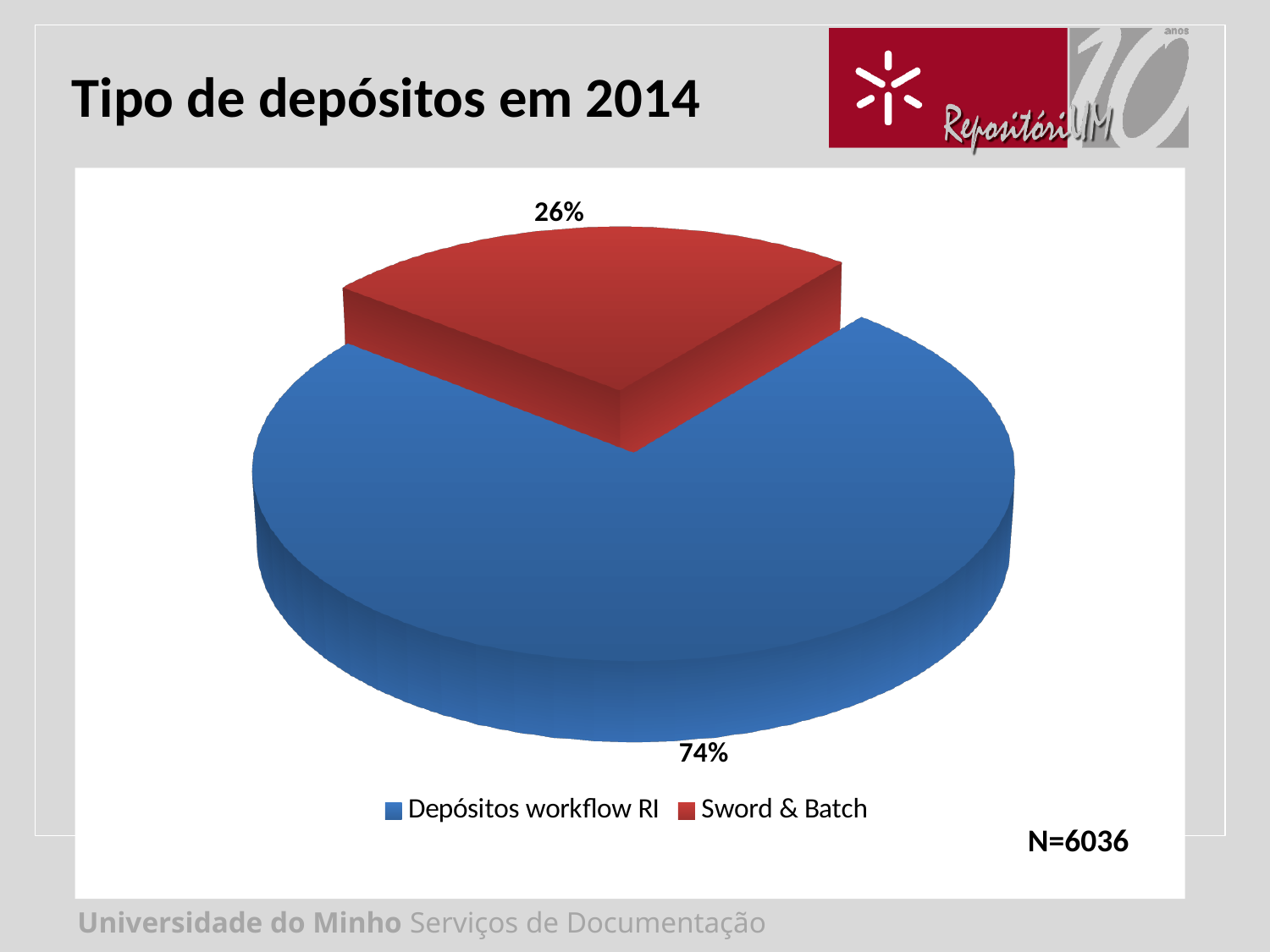
What is the difference in percentage points between Depósitos workflow RI and Sword & Batch? 48 What is the value of N shown next to the chart? 6036 Which category has the largest slice of the pie? Depósitos workflow RI How many entries does the legend list? 2 Which is larger, the share for Sword & Batch or the share for Depósitos workflow RI? Depósitos workflow RI What colour is the slice for Sword & Batch? red What is the title of the slide containing the chart? Tipo de depósitos em 2014 What share of the pie does Depósitos workflow RI represent? 74% Which category has the smallest slice of the pie? Sword & Batch What share of the pie does Sword & Batch represent? 26% What kind of chart is shown on the slide? pie chart How many slices does the pie chart have? 2